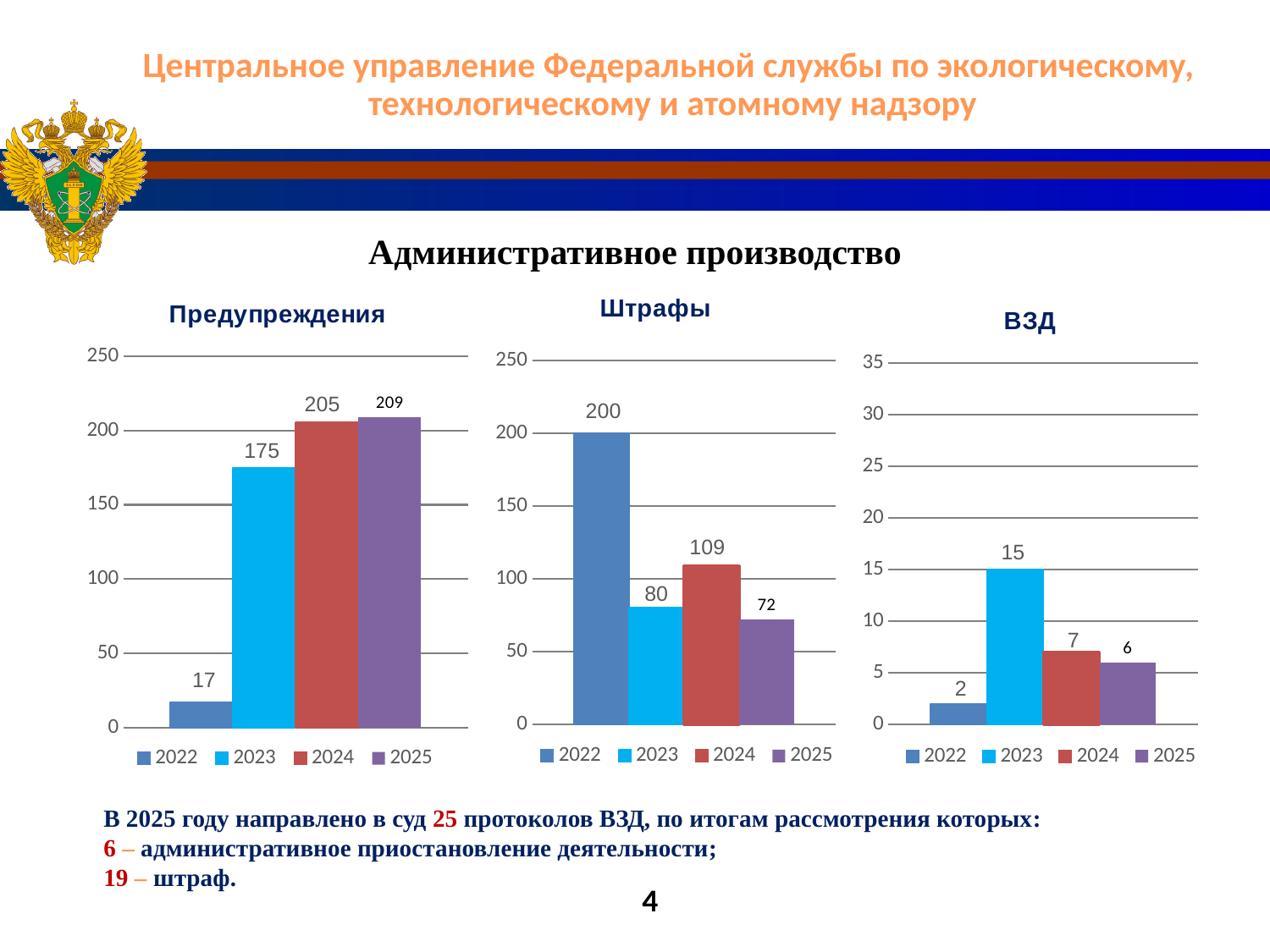
In the 'Предупреждения' chart, what is the value for 2023? 175 In the 'Предупреждения' chart, which year has the lowest value? 2022 In the 'ВЗД' chart, how many series does the legend list? 4 In the 'Штрафы' chart, what is the difference between the 2024 and 2025 values? 37 In the 'Предупреждения' chart, do the values rise or fall from 2022 to 2025? rise In the 'Штрафы' chart, what is the value for 2022? 200 In the 'ВЗД' chart, what is the value for 2023? 15 In the 'ВЗД' chart, which year has the lowest value? 2022 In the 'Штрафы' chart, which is larger, the value for 2023 or the value for 2024? 2024 In the 'Предупреждения' chart, what is the difference between the 2025 and 2024 values? 4 What kind of chart is the 'Предупреждения' chart? bar chart In the 'Штрафы' chart, which year has the highest value? 2022